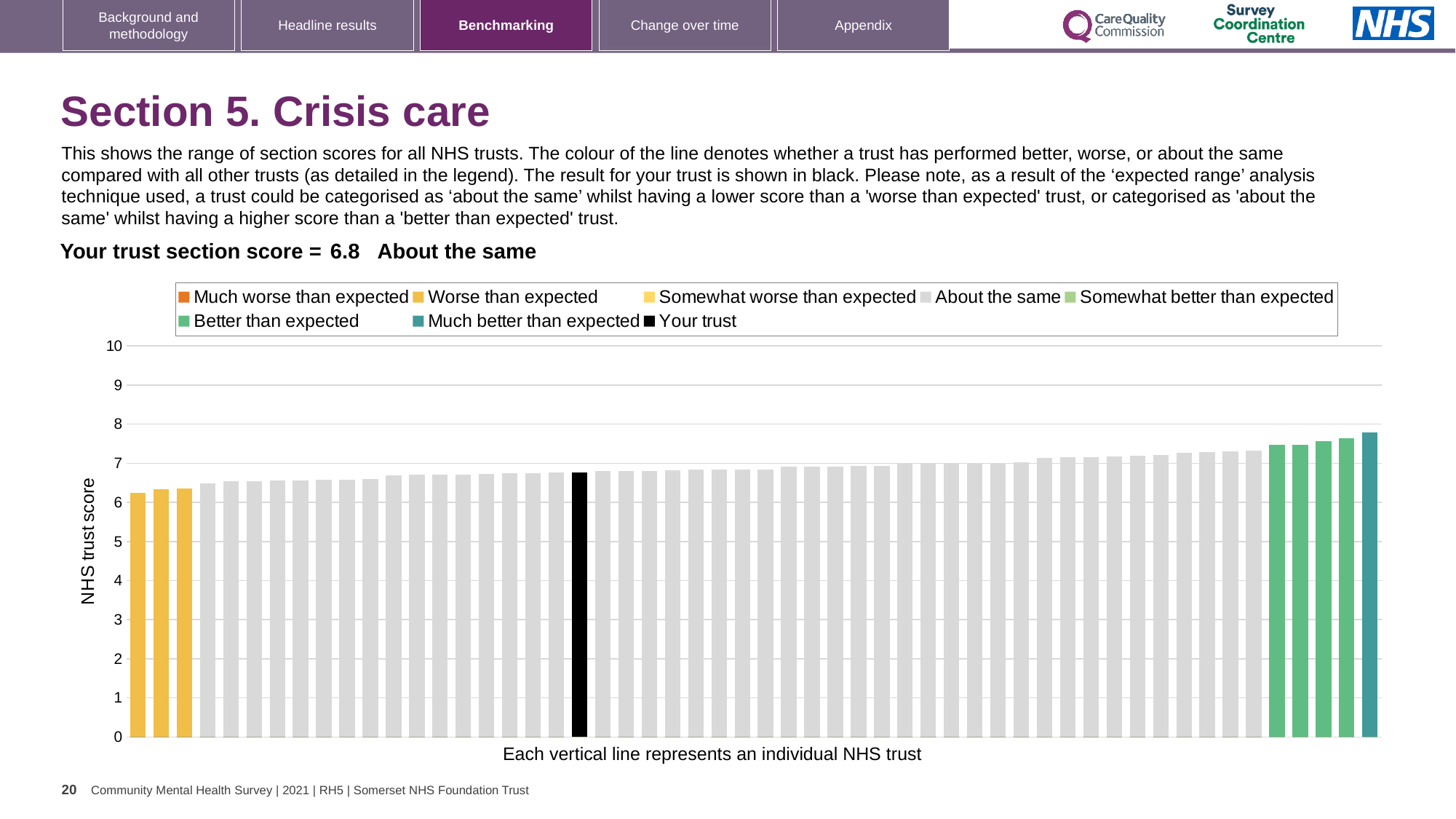
What kind of chart is shown on the slide? bar chart How many bars are coloured as 'Worse than expected'? 3 What is the section score for your trust shown on the slide? 6.8 Do the bar values rise or fall from left to right along the x axis? rise Which is larger: the bar for your trust or the 'Much better than expected' bar? Much better than expected What is the label on the vertical axis of the chart? NHS trust score Is the value of the tallest bar greater or less than 8? less How many bars are coloured as 'Better than expected'? 4 Which benchmarking category is your trust placed in for Crisis care? About the same Is the value of the shortest bar greater or less than 6? greater How many entries does the chart legend list? 8 How many bars are coloured as 'Much better than expected'? 1